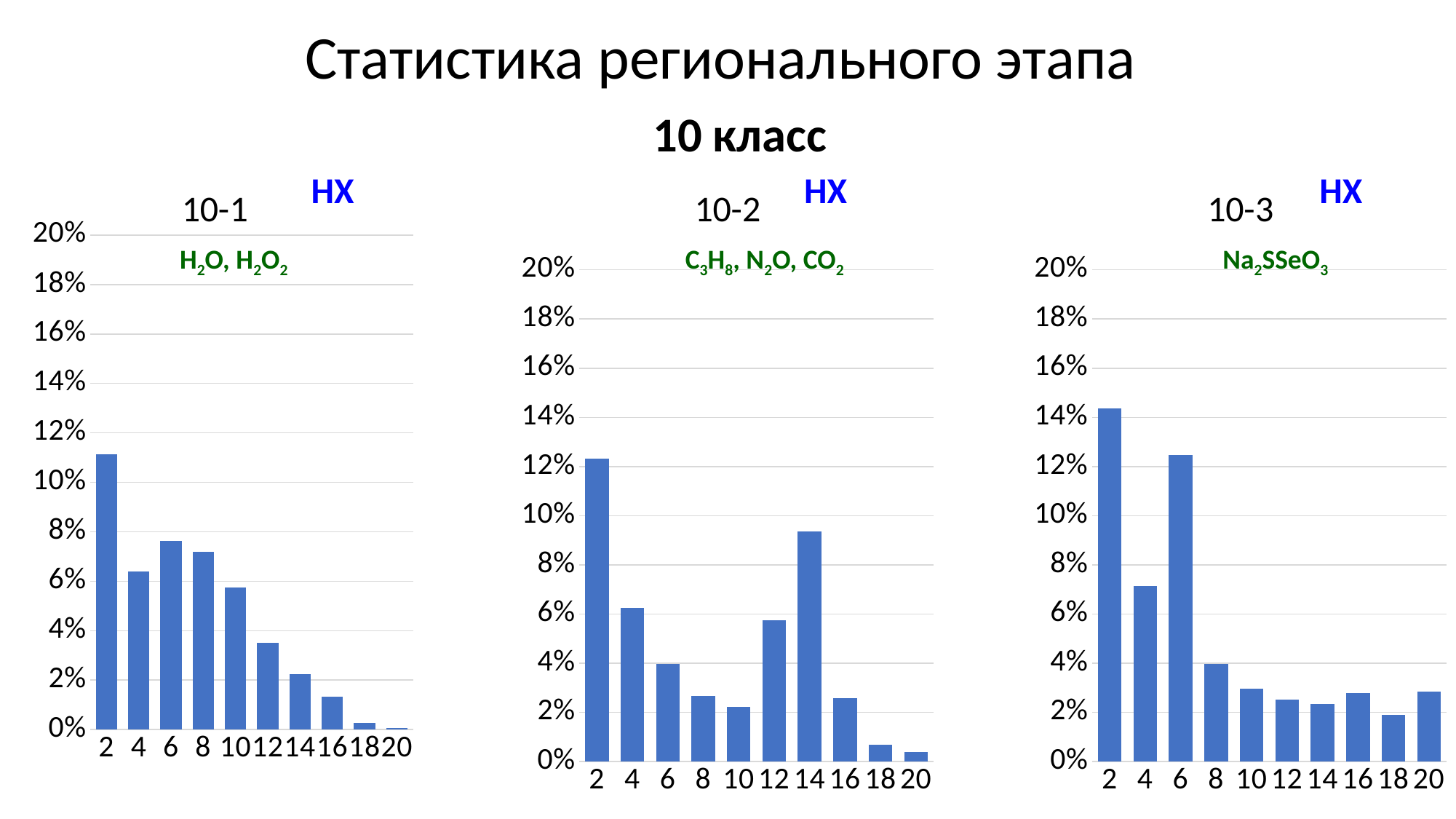
In the 10-2 chart, is the value for 14 greater or less than 10%? less In the 10-3 chart, which is larger: the value for 2 or the value for 6? 2 In the 10-2 chart, which category has the lowest bar? 20 In the 10-3 chart, which category has the lowest bar? 18 In the 10-1 chart, do the values generally rise or fall from category 2 to category 20? fall In the 10-2 chart, which category has the highest bar? 2 In the 10-1 chart, is the value for 2 greater or less than 10%? greater How many categories are shown on the x axis of the 10-2 chart? 10 In the 10-1 chart, which category has the highest bar? 2 In the 10-1 chart, which category has the lowest bar? 20 In the 10-2 chart, which is larger: the value for 12 or the value for 14? 14 What kind of chart is the 10-1 chart? bar chart